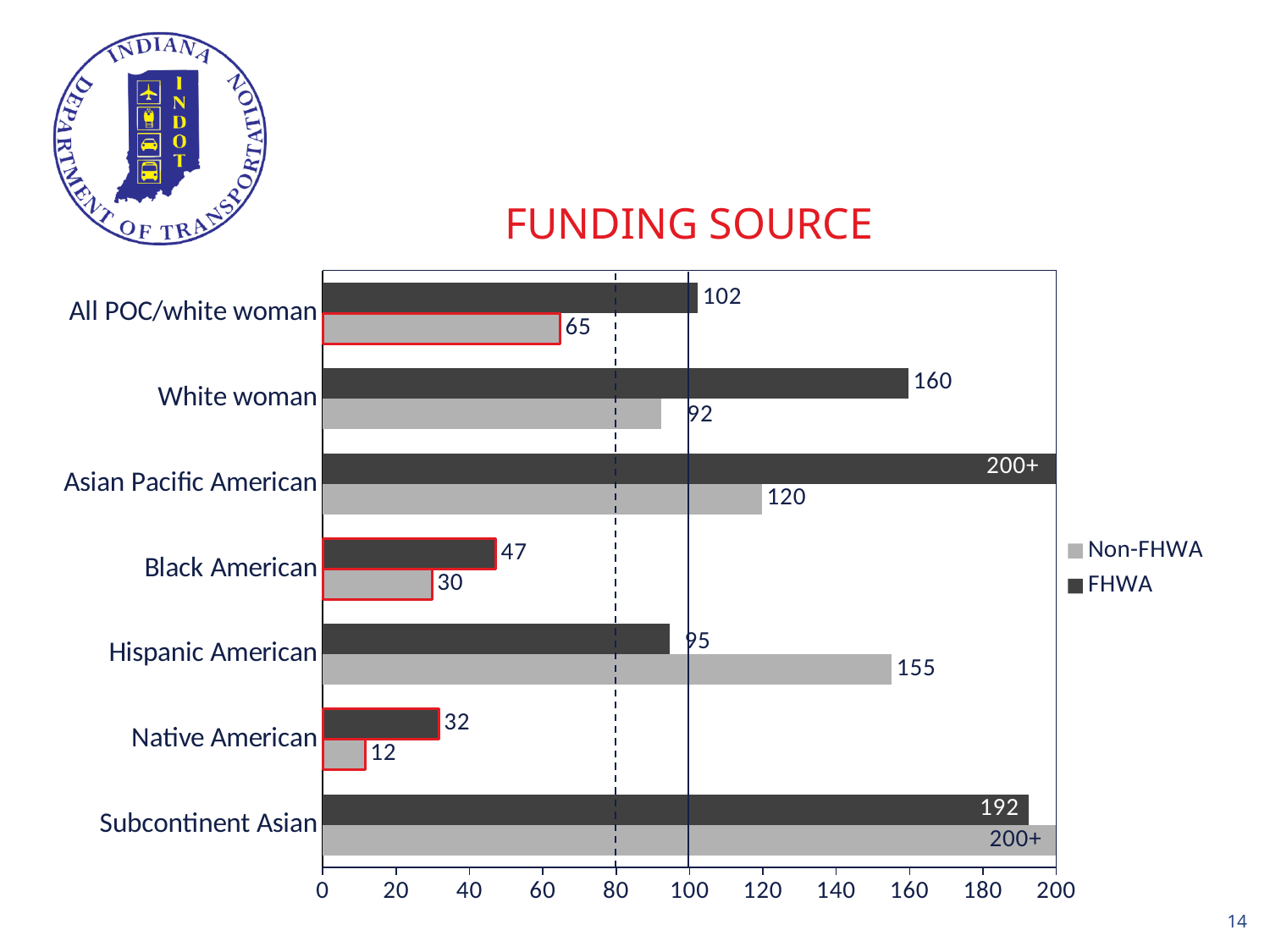
What is the difference between the Non-FHWA and FHWA values for Hispanic American? 60 How many categories are shown on the chart? 7 What is the Non-FHWA value for Hispanic American? 155 What is the Non-FHWA value for Native American? 12 How many series does the legend list? 2 Which category has the lowest Non-FHWA value? Native American What kind of chart is shown on the slide? Bar chart Which is larger for Black American, the FHWA value or the Non-FHWA value? FHWA What is the FHWA value for Subcontinent Asian? 192 Which category has the lowest FHWA value? Native American What is the FHWA value for White woman? 160 What is the difference between the FHWA and Non-FHWA values for White woman? 68